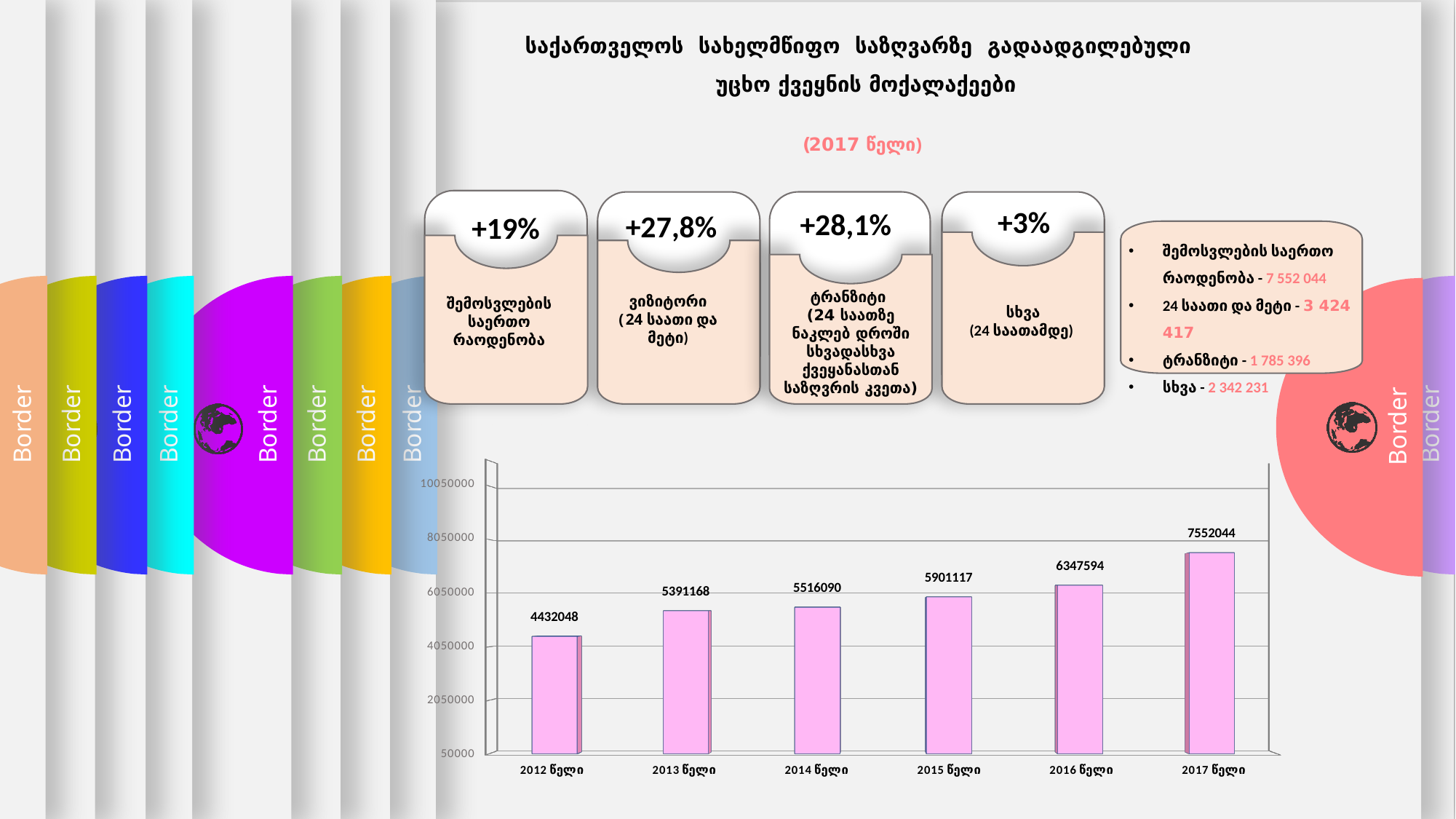
What is the value shown for 2015 (2015 წელი) in the bar chart? 5901117 Which year has the highest value in the bar chart? 2017 წელი How many years (bars) are shown in the bar chart? 6 What is the difference between the values for 2017 and 2016 in the bar chart? 1204450 What is the value shown for 2017 (2017 წელი) in the bar chart? 7552044 Which is larger in the bar chart, the value for 2014 or the value for 2016? 2016 Is the value for 2016 in the bar chart greater or less than 6050000? greater What is the value shown for 2012 (2012 წელი) in the bar chart? 4432048 Do the values in the bar chart rise or fall from 2012 to 2017? rise What is the difference between the values for 2013 and 2012 in the bar chart? 959120 Which year has the lowest value in the bar chart? 2012 წელი What kind of chart is shown at the bottom of the slide? bar chart